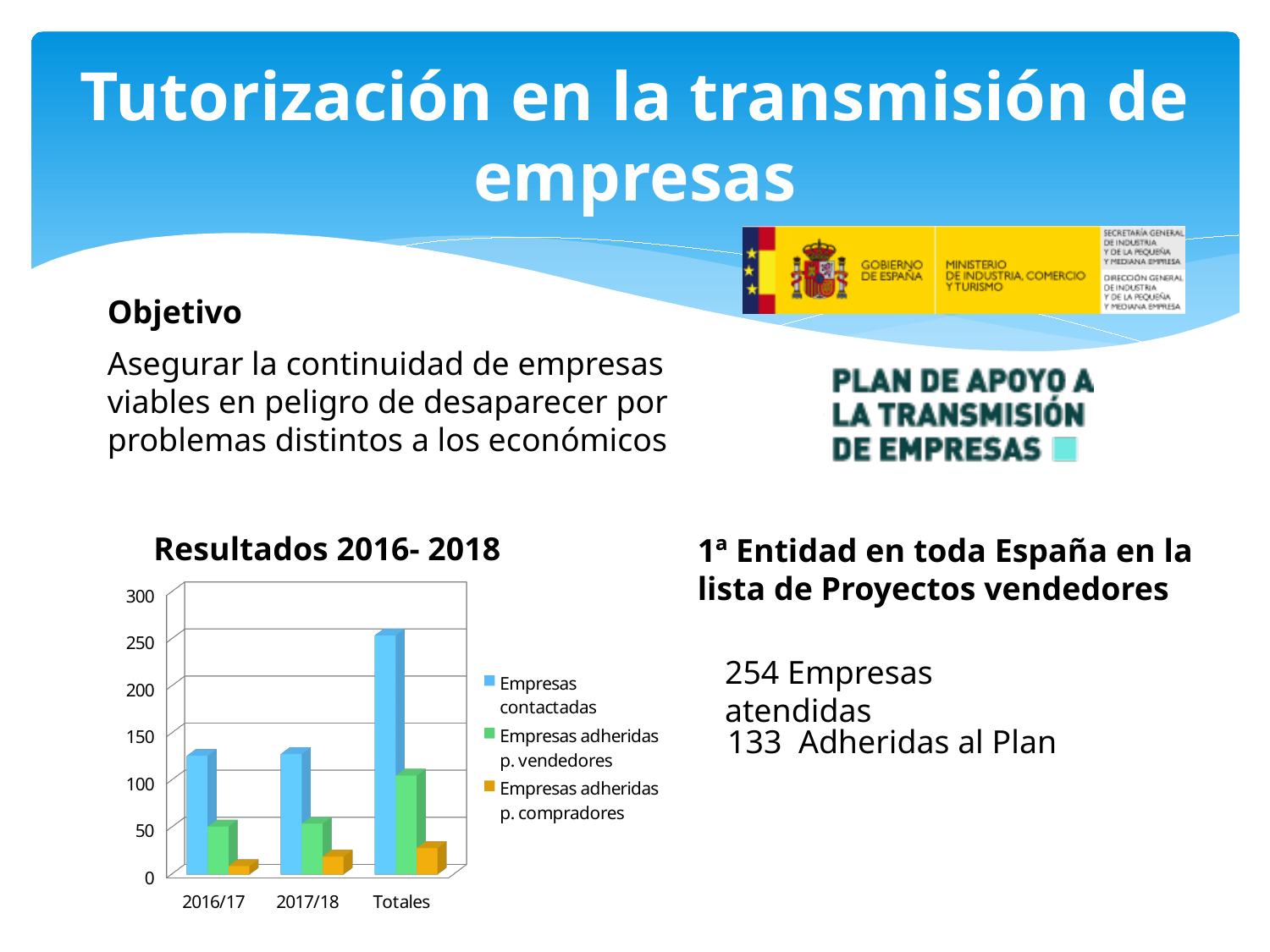
Is the value for Empresas adheridas p. vendedores in Totales greater or less than 150? less Do the values for Empresas adheridas p. vendedores rise or fall from 2016/17 to Totales? rise What kind of chart is shown on the slide? bar chart Which series is shown in green in the chart? Empresas adheridas p. vendedores Is the value for Empresas contactadas in 2016/17 greater or less than 100? greater What is the title of the chart? Resultados 2016- 2018 In Totales, which is larger: Empresas contactadas or Empresas adheridas p. vendedores? Empresas contactadas How many series does the chart legend list? 3 Which category has the highest value for Empresas contactadas? Totales Is the value for Empresas adheridas p. compradores in Totales greater or less than 50? less How many categories are shown on the x axis of the chart? 3